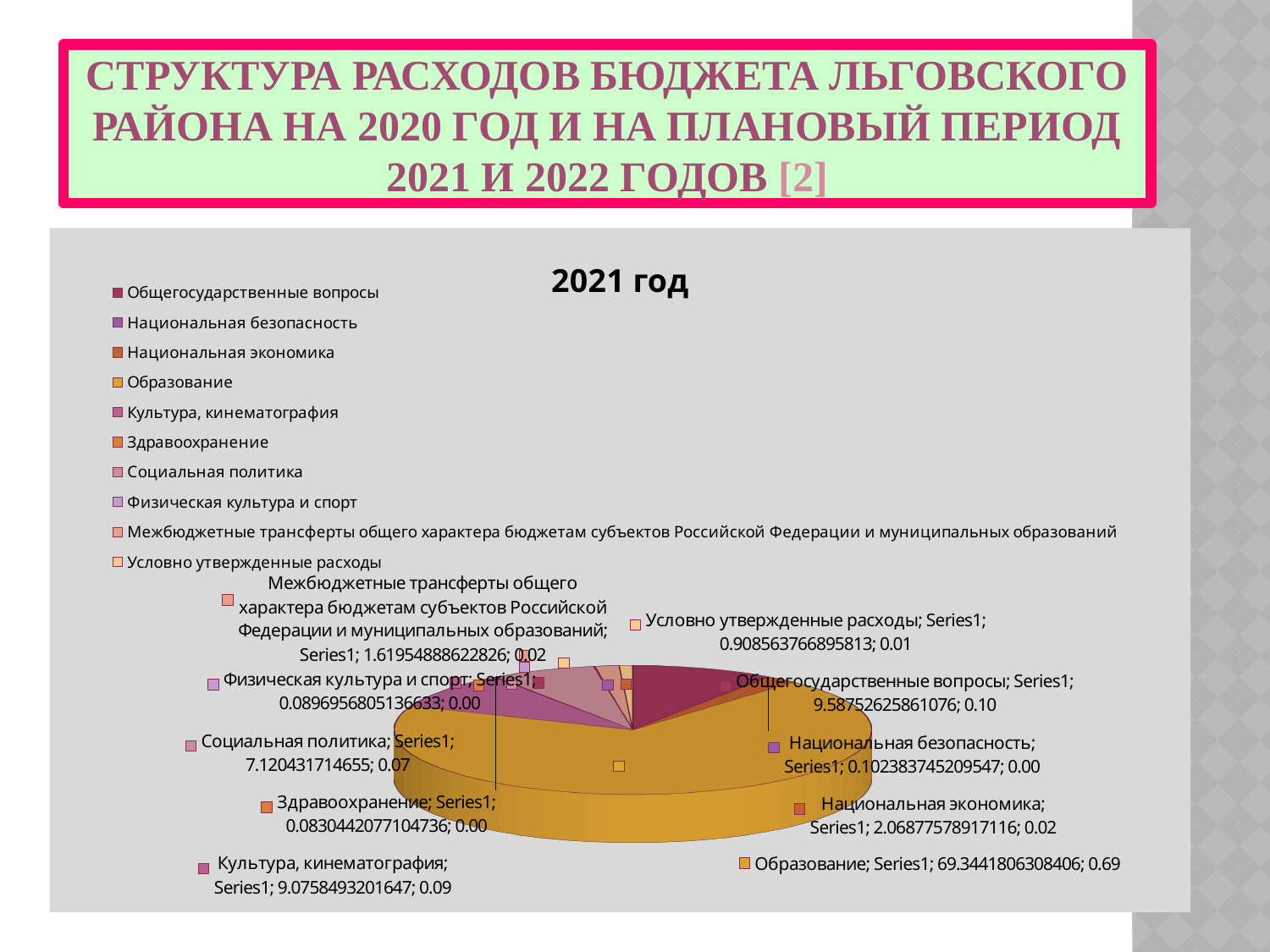
What is the difference between the values for Культура, кинематография and Социальная политика? 1.9554176055097 What type of chart is shown on the slide? pie chart Which category has the largest slice in the chart? Образование What is the value for Образование in the chart? 69.3441806308406 Which is larger in the chart: Культура, кинематография or Социальная политика? Культура, кинематография What share of the pie does Образование represent, as labelled on the chart? 0.69 What is the title of the chart? 2021 год What is the value for Национальная экономика in the chart? 2.06877578917116 What share of the pie does Культура, кинематография represent, as labelled on the chart? 0.09 What is the value for Социальная политика in the chart? 7.120431714655 What is the value for Общегосударственные вопросы in the chart? 9.58752625861076 How many categories does the legend of the chart list? 10